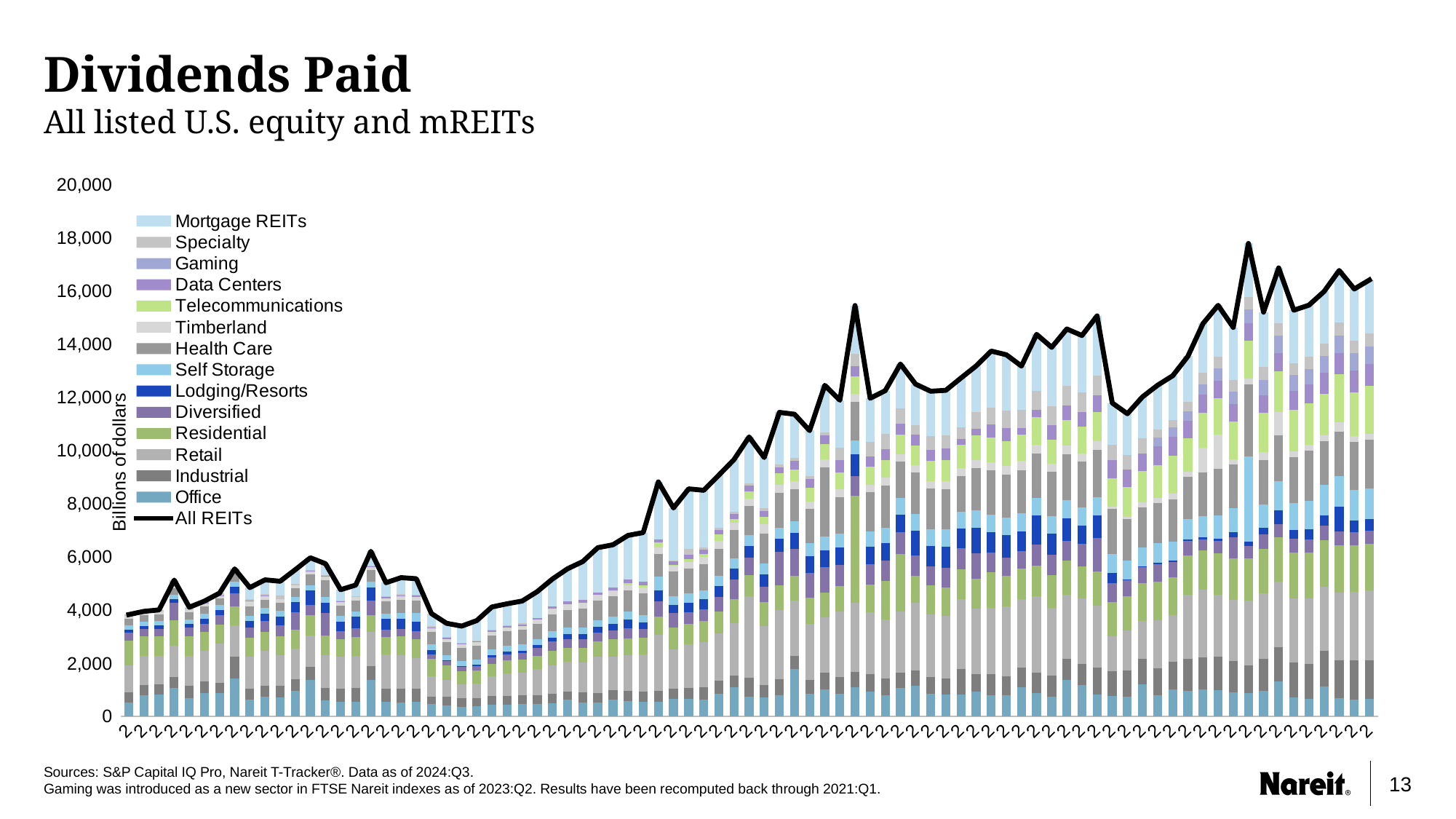
Do the All REITs values generally rise or fall from left to right along the x axis? rise What kind of chart is shown on the slide? combination bar and line chart Is the highest value of the All REITs line greater or less than 16,000? greater What is the label on the vertical axis? Billions of dollars How many series does the legend list? 15 What is the title of the chart? Dividends Paid Is the lowest value of the All REITs line greater or less than 4,000? less